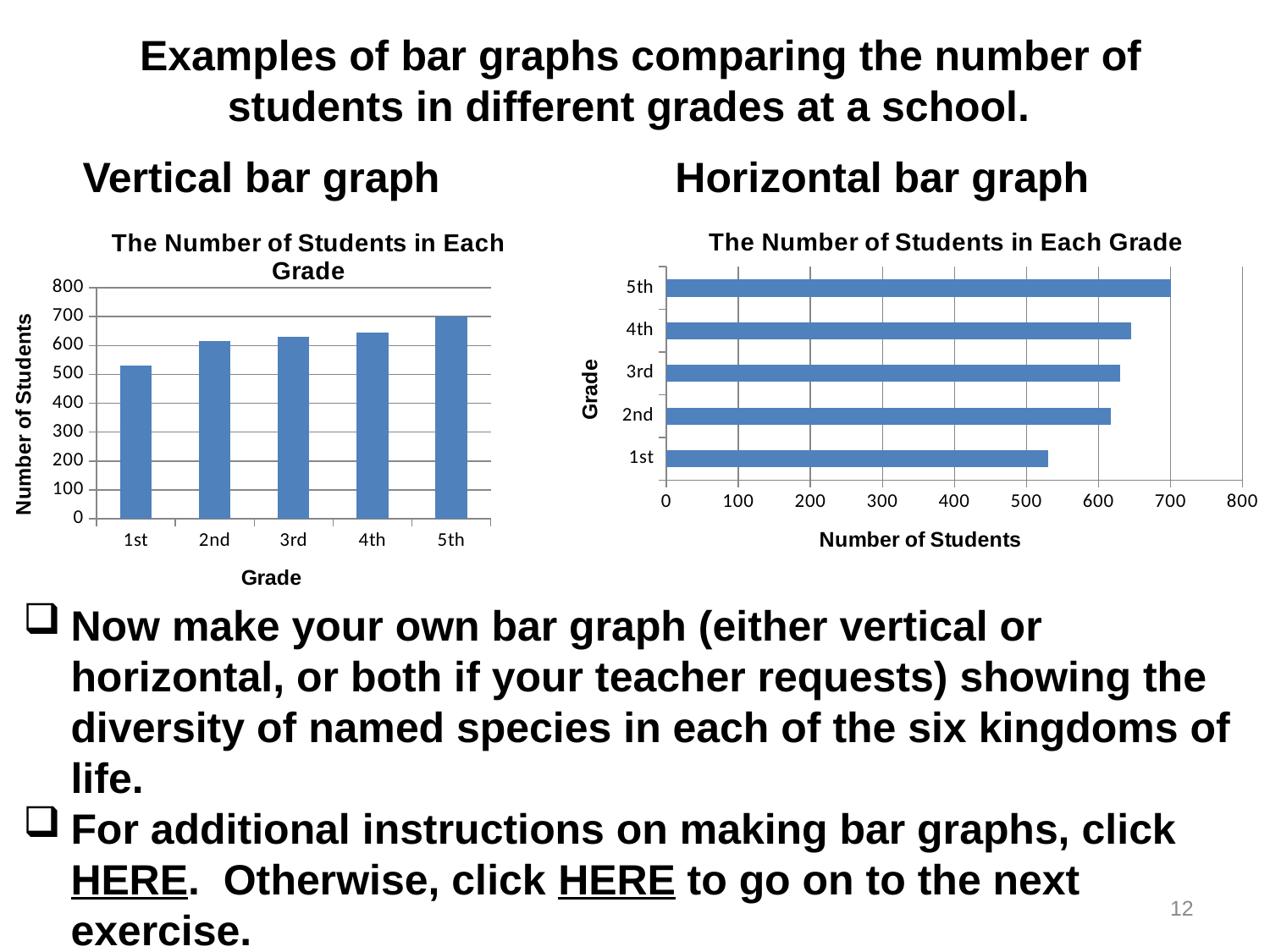
What is the title of the horizontal bar graph (right chart)? The Number of Students in Each Grade On the vertical bar graph (left chart), is the value for 1st grade greater or less than 600? less On the horizontal bar graph (right chart), which is larger, the value for 1st grade or the value for 5th grade? 5th On the horizontal bar graph (right chart), which grade has the fewest students? 1st On the vertical bar graph (left chart), what is the label of the y axis? Number of Students On the horizontal bar graph (right chart), is the value for 4th grade greater or less than 600? greater On the vertical bar graph (left chart), which grade has the highest number of students? 5th On the vertical bar graph (left chart), which grade has the lowest number of students? 1st On the vertical bar graph (left chart), do the values rise or fall from 1st grade to 5th grade? rise On the horizontal bar graph (right chart), what kind of chart is shown? Bar chart On the vertical bar graph (left chart), how many grades are plotted? 5 On the vertical bar graph (left chart), what kind of chart is shown? Bar chart